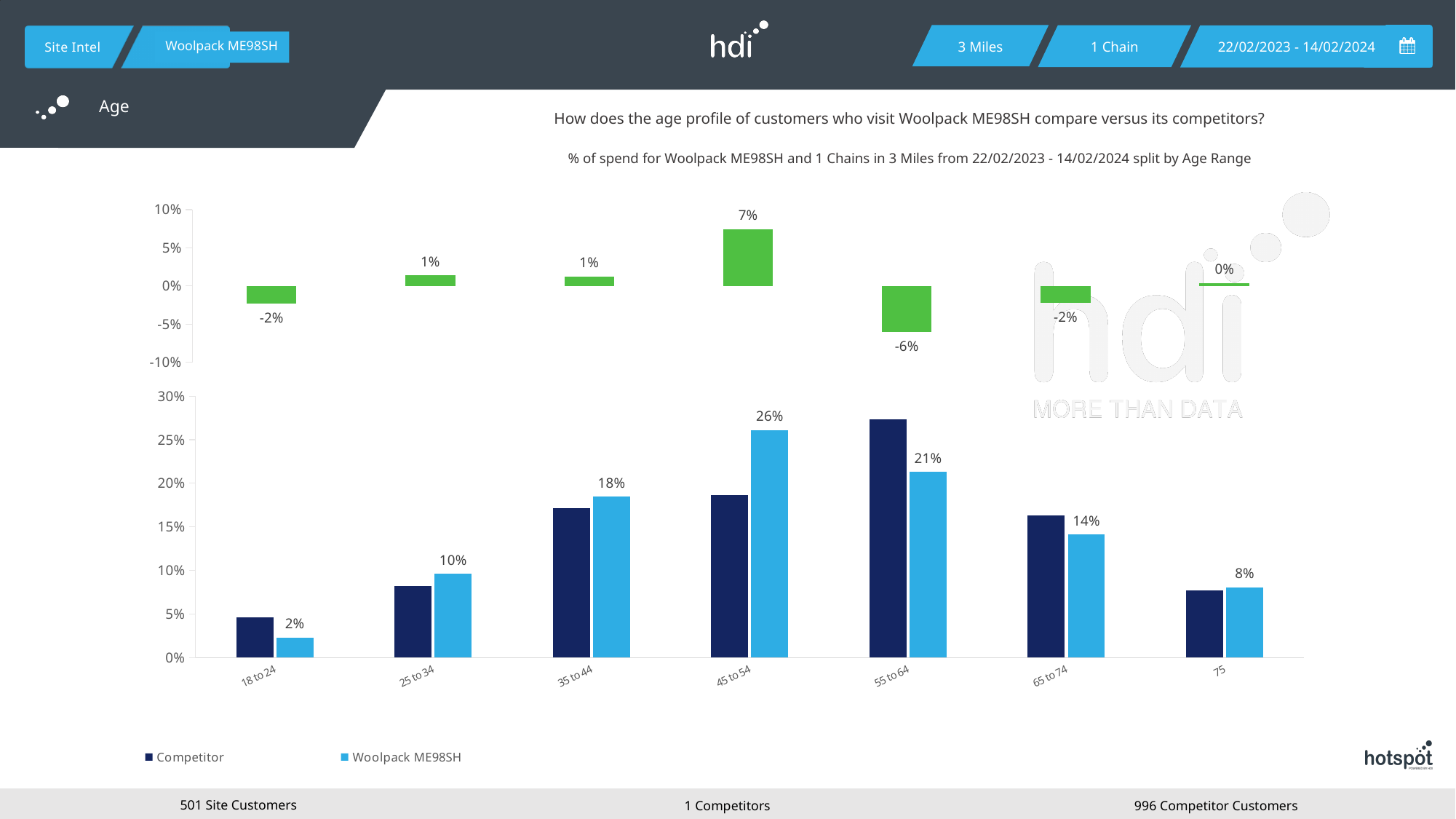
In the bottom bar chart, is the Competitor value for 55 to 64 greater or less than 25%? greater In the bottom bar chart, what is the value for Woolpack ME98SH in the 45 to 54 age range? 26% In the top chart of green bars, what is the value for the 55 to 64 age range? -6% In the bottom bar chart, what is the value for Woolpack ME98SH in the 18 to 24 age range? 2% In the bottom bar chart, which is larger for the 55 to 64 age range, the Competitor bar or the Woolpack ME98SH bar? Competitor In the bottom bar chart, what is the difference between the Woolpack ME98SH values for 45 to 54 and 55 to 64? 5% In the bottom bar chart, which age range has the highest Woolpack ME98SH value? 45 to 54 How many series does the legend of the bottom bar chart list? 2 In the bottom bar chart, which age range has the lowest Woolpack ME98SH value? 18 to 24 How many age range categories are shown on the x axis of the bottom bar chart? 7 In the top chart of green bars, which age range has the highest value? 45 to 54